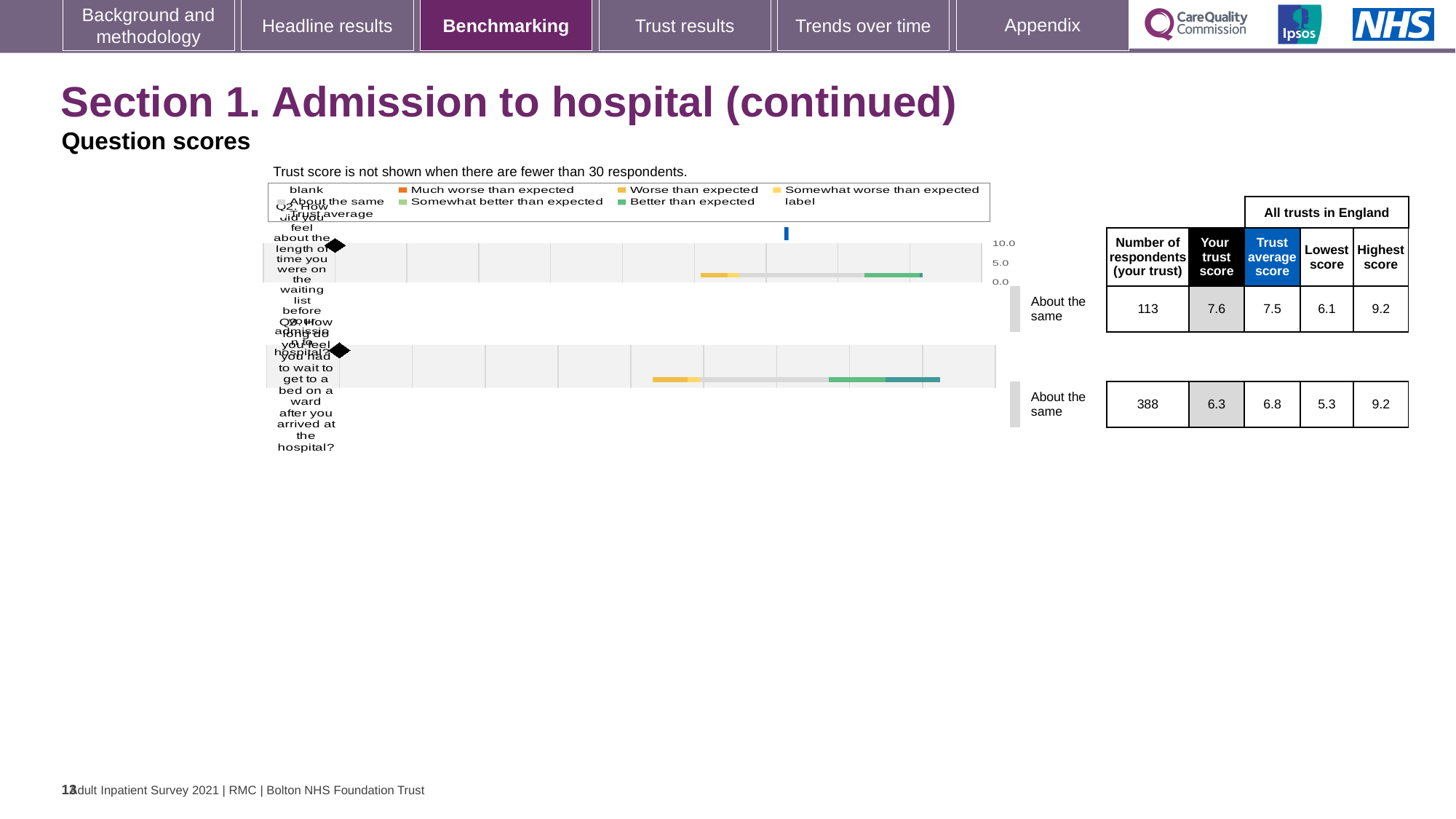
What kind of chart is used to show the question scores? Bar chart What is the 'Your trust score' for Q3 (how long did you feel you had to wait to get to a bed on a ward)? 6.3 What is the difference between the trust score and the trust average score for Q2? 0.1 What is the 'Your trust score' for Q2 (how did you feel about the length of time on the waiting list)? 7.6 What benchmark category is shown for both Q2 and Q3? About the same How many questions are plotted on this slide? 2 How many respondents answered Q3 for this trust? 388 Which question has the higher 'Your trust score', Q2 or Q3? Q2 What is the trust average score across all trusts in England for Q2? 7.5 For Q3, which is larger: the trust score or the trust average score? Trust average score What is the lowest score among all trusts in England for Q3? 5.3 What is the highest score among all trusts in England for Q2? 9.2